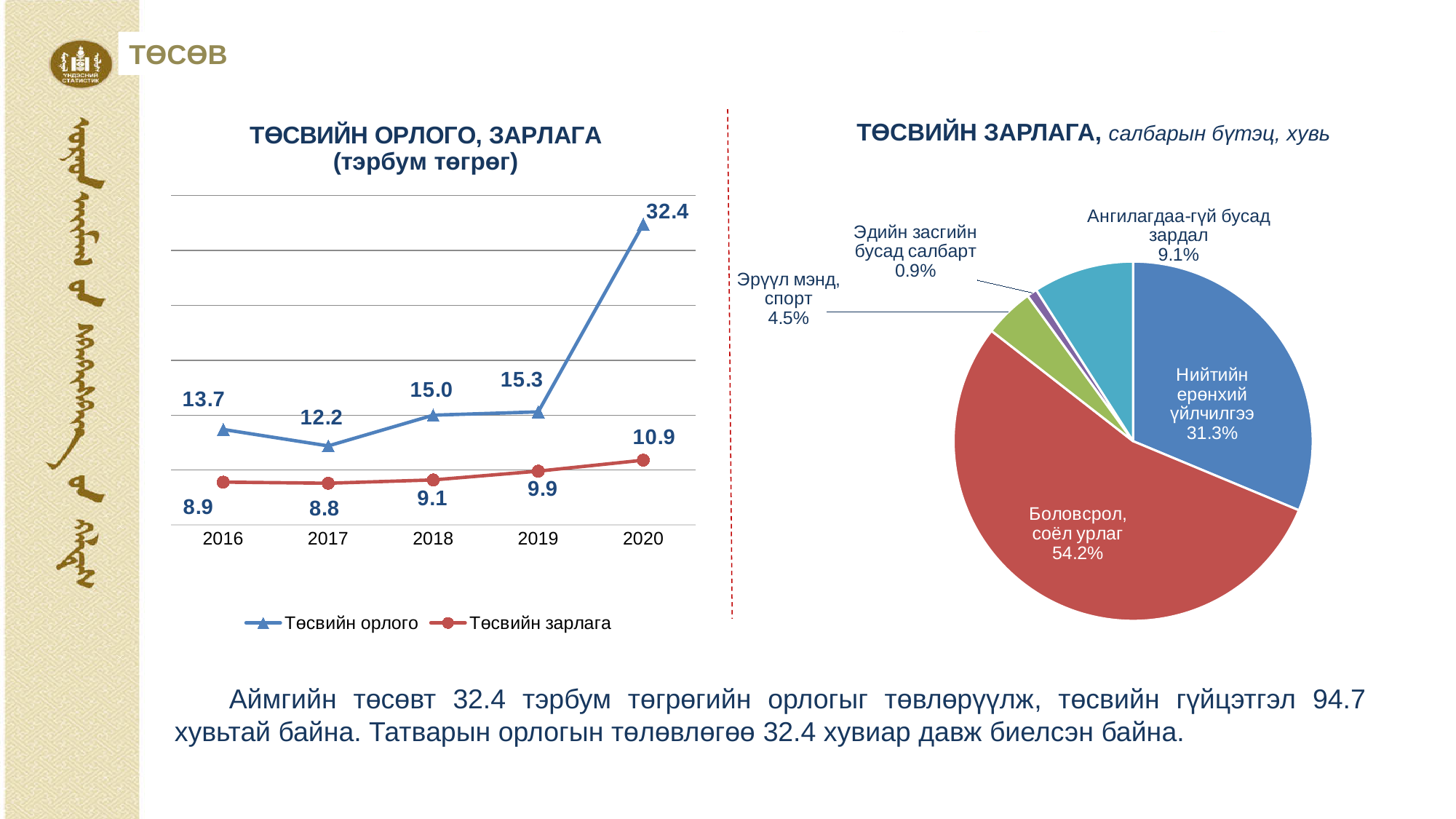
In the pie chart 'ТӨСВИЙН ЗАРЛАГА, салбарын бүтэц, хувь', how many slices are there? 5 In the line chart 'ТӨСВИЙН ОРЛОГО, ЗАРЛАГА', what is the value of Төсвийн орлого in 2020? 32.4 In the line chart 'ТӨСВИЙН ОРЛОГО, ЗАРЛАГА', how many years are shown on the x axis? 5 In the line chart 'ТӨСВИЙН ОРЛОГО, ЗАРЛАГА', which year has the lowest value for Төсвийн орлого? 2017 In the pie chart 'ТӨСВИЙН ЗАРЛАГА, салбарын бүтэц, хувь', what share does Боловсрол, соёл урлаг have? 54.2% In the line chart 'ТӨСВИЙН ОРЛОГО, ЗАРЛАГА', what is the value of Төсвийн зарлага in 2017? 8.8 In the line chart 'ТӨСВИЙН ОРЛОГО, ЗАРЛАГА', how many series does the legend list? 2 In the line chart 'ТӨСВИЙН ОРЛОГО, ЗАРЛАГА', does Төсвийн зарлага rise or fall from 2017 to 2020? Rise In the line chart 'ТӨСВИЙН ОРЛОГО, ЗАРЛАГА', what is the difference between Төсвийн орлого and Төсвийн зарлага in 2020? 21.5 What kind of chart is 'ТӨСВИЙН ОРЛОГО, ЗАРЛАГА'? Line chart In the pie chart 'ТӨСВИЙН ЗАРЛАГА, салбарын бүтэц, хувь', which slice is the smallest? Эдийн засгийн бусад салбарт In the pie chart 'ТӨСВИЙН ЗАРЛАГА, салбарын бүтэц, хувь', which is larger: Эрүүл мэнд, спорт or Ангилагдаа-гүй бусад зардал? Ангилагдаа-гүй бусад зардал